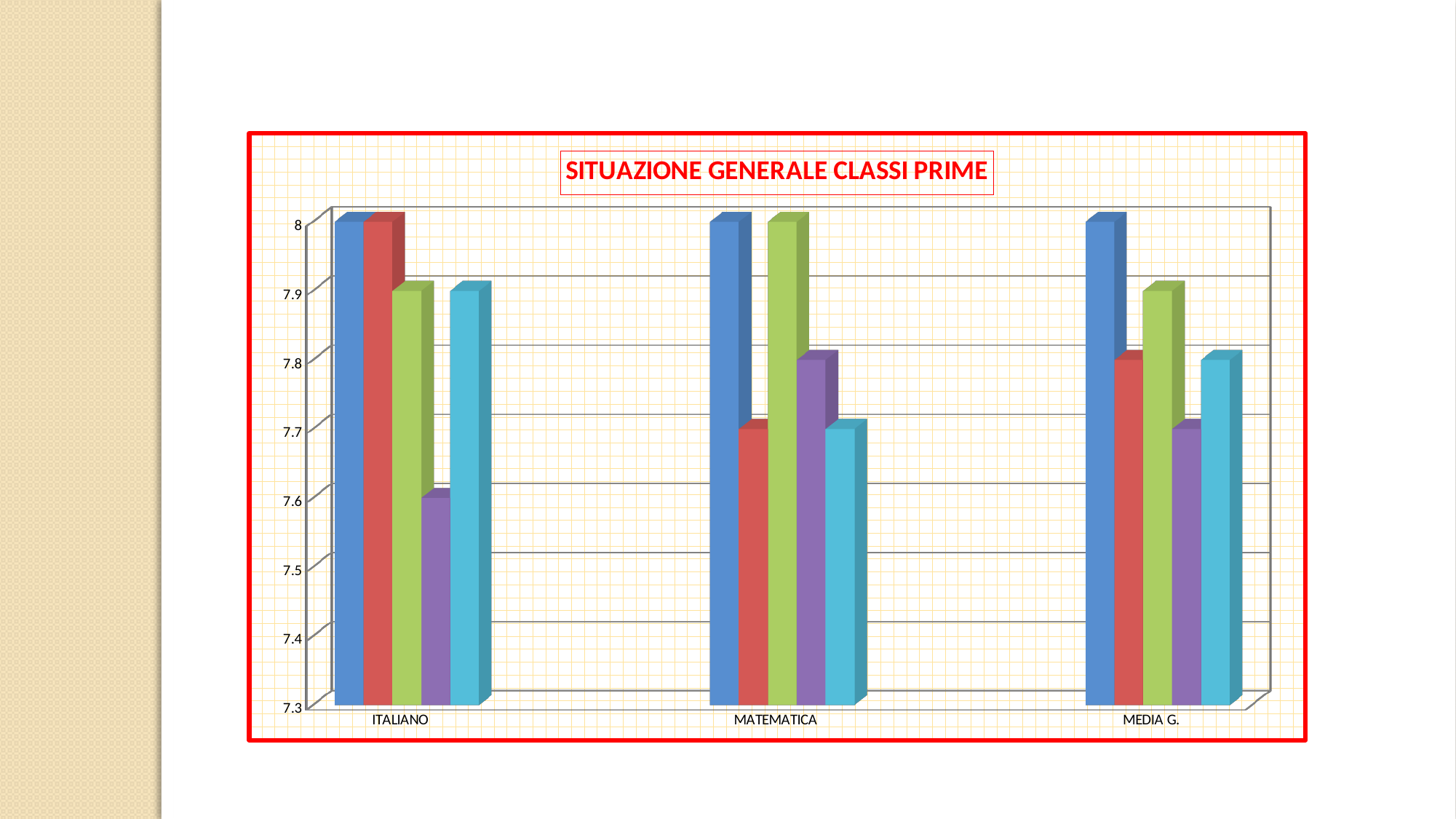
In the MATEMATICA group, is the red bar or the green bar higher? green In the MATEMATICA group, what value does the green bar reach? 8 How many categories are shown on the x axis of the chart? 3 What kind of chart is shown on the slide? bar chart In the ITALIANO group, which coloured bar is the lowest? purple What is the lowest value shown on the vertical axis of the chart? 7.3 In the ITALIANO group, what is the difference between the blue bar and the purple bar? 0.4 Is the value of the purple bar in the ITALIANO group greater or less than 7.7? less How many bars are plotted in each category group of the chart? 5 In the MEDIA G. group, what value does the red bar reach? 7.8 What is the title of the chart? SITUAZIONE GENERALE CLASSI PRIME In the ITALIANO group, what value does the purple bar reach? 7.6